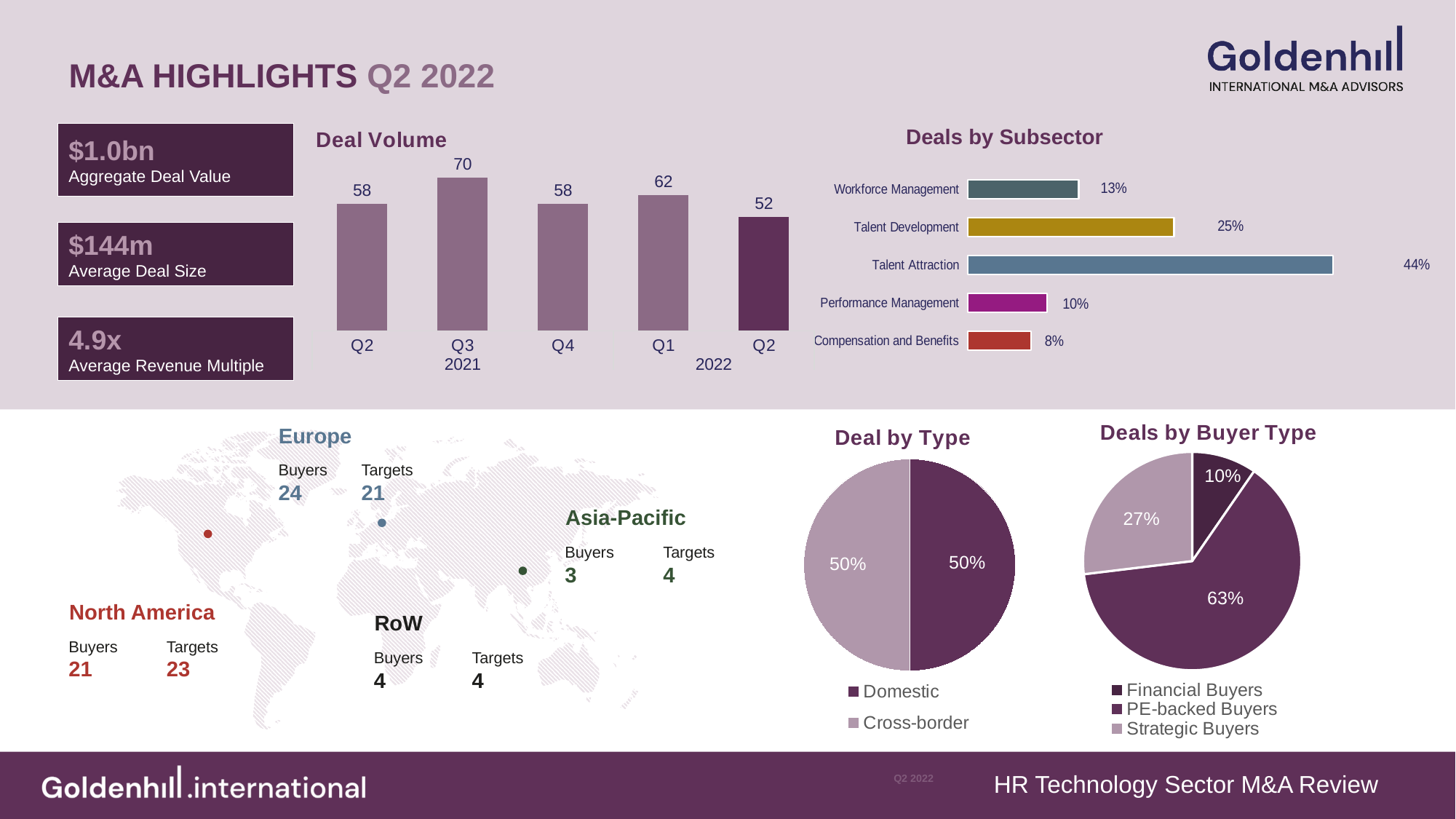
How many entries does the legend of the Deals by Buyer Type chart list? 3 In the Deals by Subsector chart, which subsector has the smallest share? Compensation and Benefits In the Deals by Subsector chart, what is the value for Talent Attraction? 44% In the Deals by Subsector chart, what is the difference between Talent Development and Workforce Management? 12% In the Deal Volume chart, what is the difference between Q3 2021 and Q2 2022? 18 In the Deal by Type pie chart, what share is Cross-border? 50% What kind of chart is the Deals by Subsector chart? Bar chart In the Deal Volume chart, is the value for Q1 2022 larger or smaller than the value for Q4 2021? larger In the Deals by Buyer Type pie chart, which buyer type has the largest share? PE-backed Buyers In the Deal Volume chart, which quarter has the lowest deal volume? Q2 2022 In the Deal Volume chart, how many quarters are plotted? 5 In the Deal Volume chart, what is the value for Q3 2021? 70